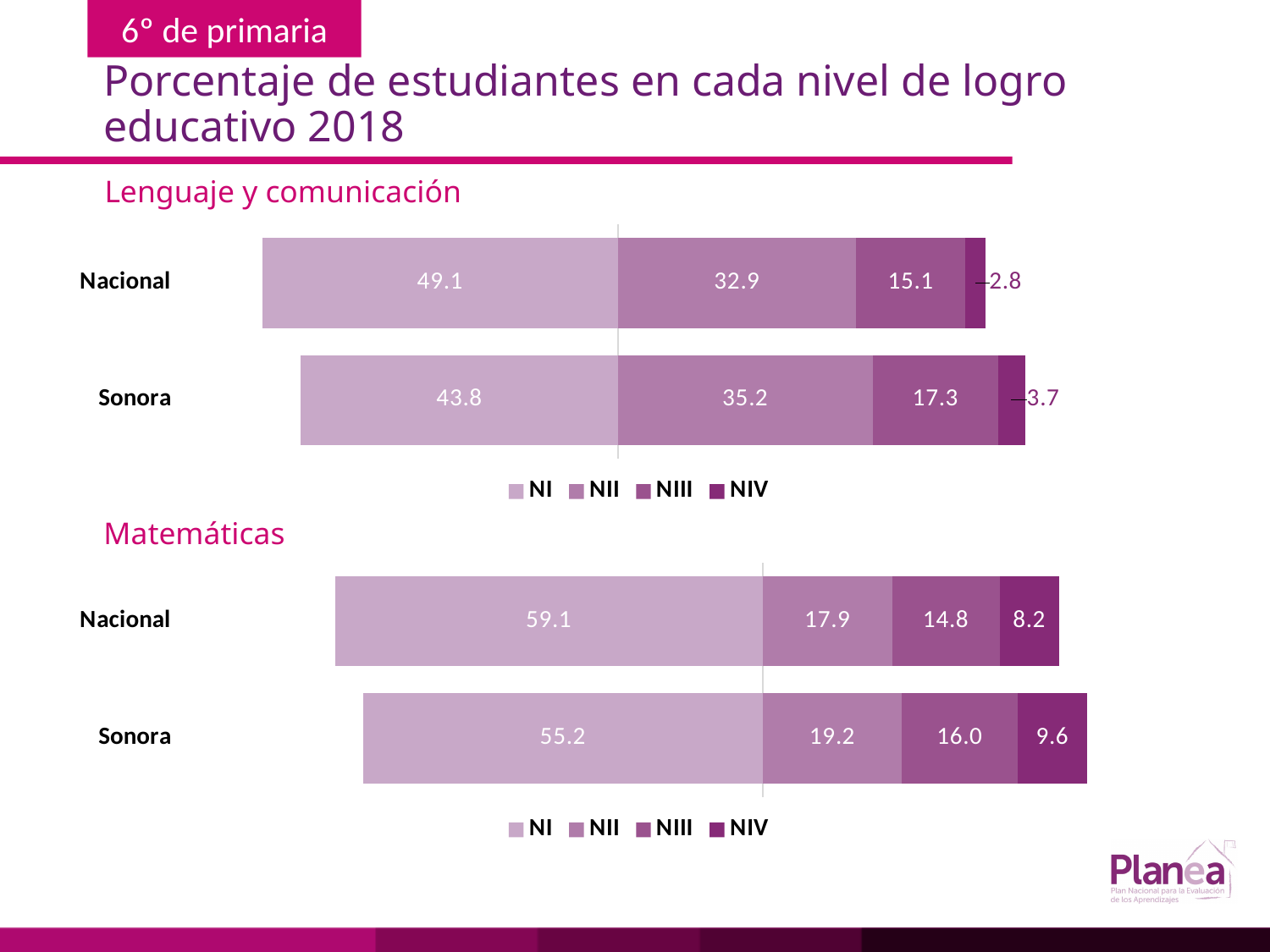
In the Lenguaje y comunicación chart, which series has the highest value for Sonora? NI In the Lenguaje y comunicación chart, what is the NIV value for Sonora? 3.7 In the Matemáticas chart, which is larger: the NIV value for Nacional or for Sonora? Sonora In the Matemáticas chart, what is the NIII value for Nacional? 14.8 What kind of chart is the Lenguaje y comunicación chart? Stacked bar chart In the Lenguaje y comunicación chart, what is the NI value for Nacional? 49.1 How many series does the legend of the Lenguaje y comunicación chart list? 4 How many categories are shown in the Matemáticas chart? 2 In the Matemáticas chart, what is the total of the stacked bar for Sonora? 100.0 In the Lenguaje y comunicación chart, what is the difference between the NI values for Nacional and Sonora? 5.3 In the Matemáticas chart, which series has the lowest value for Nacional? NIV In the Matemáticas chart, what is the NII value for Sonora? 19.2